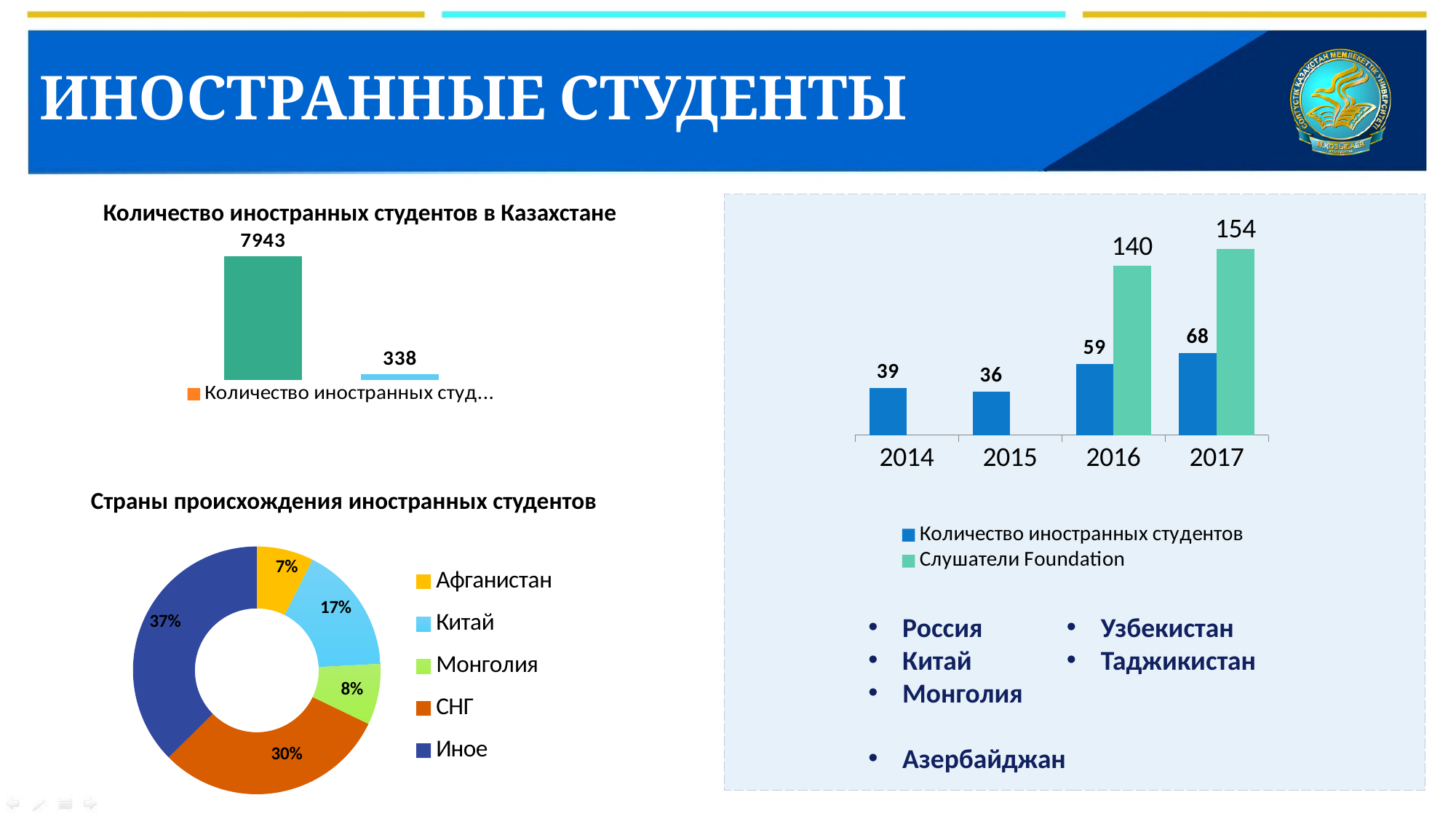
In the chart titled 'Страны происхождения иностранных студентов', which category has the largest share? Иное In the chart titled 'Количество иностранных студентов в Казахстане', what is the value of the taller bar? 7943 In the chart on the right of the slide, what is the difference between the Слушатели Foundation values for 2017 and 2016? 14 In the chart on the right of the slide, how many series does the legend list? 2 In the chart on the right of the slide, what is the value for Слушатели Foundation in 2016? 140 In the chart on the right of the slide, does the value for Количество иностранных студентов rise or fall from 2015 to 2017? rise In the chart on the right of the slide, what is the value for Количество иностранных студентов in 2017? 68 In the chart titled 'Страны происхождения иностранных студентов', what share does Китай have? 17% In the chart titled 'Страны происхождения иностранных студентов', which is larger, СНГ or Монголия? СНГ In the chart on the right of the slide, how many years are shown on the x axis? 4 What kind of chart is 'Страны происхождения иностранных студентов'? doughnut chart In the chart on the right of the slide, which year has the lowest value for Количество иностранных студентов? 2015